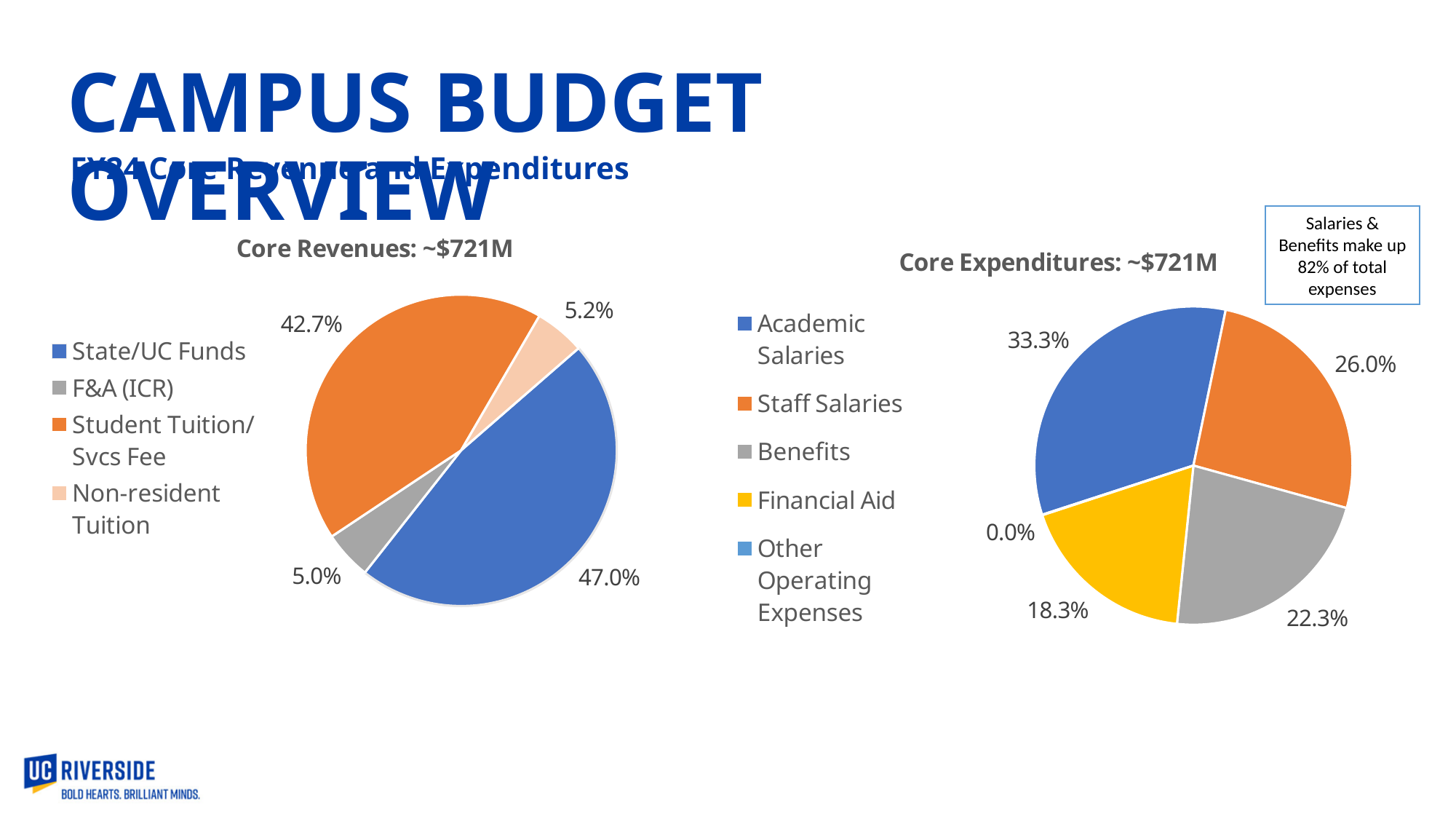
In the Core Expenditures chart, which category has the largest share? Academic Salaries How many categories does the legend of the Core Expenditures chart list? 5 In the Core Expenditures chart, what percentage is Academic Salaries? 33.3% What type of chart is the Core Revenues chart? Pie chart In the Core Revenues chart, which category has the smallest share? F&A (ICR) In the Core Expenditures chart, what percentage is Financial Aid? 18.3% In the Core Revenues chart, what is the difference between the State/UC Funds share and the Student Tuition/Svcs Fee share? 4.3% In the Core Revenues chart, what percentage is Student Tuition/Svcs Fee? 42.7% In the Core Revenues chart, which category has the largest share? State/UC Funds In the Core Revenues chart, what share of revenue comes from State/UC Funds? 47.0% In the Core Expenditures chart, which is larger, Staff Salaries or Benefits? Staff Salaries In the Core Expenditures chart, what is the difference between Staff Salaries and Benefits? 3.7%